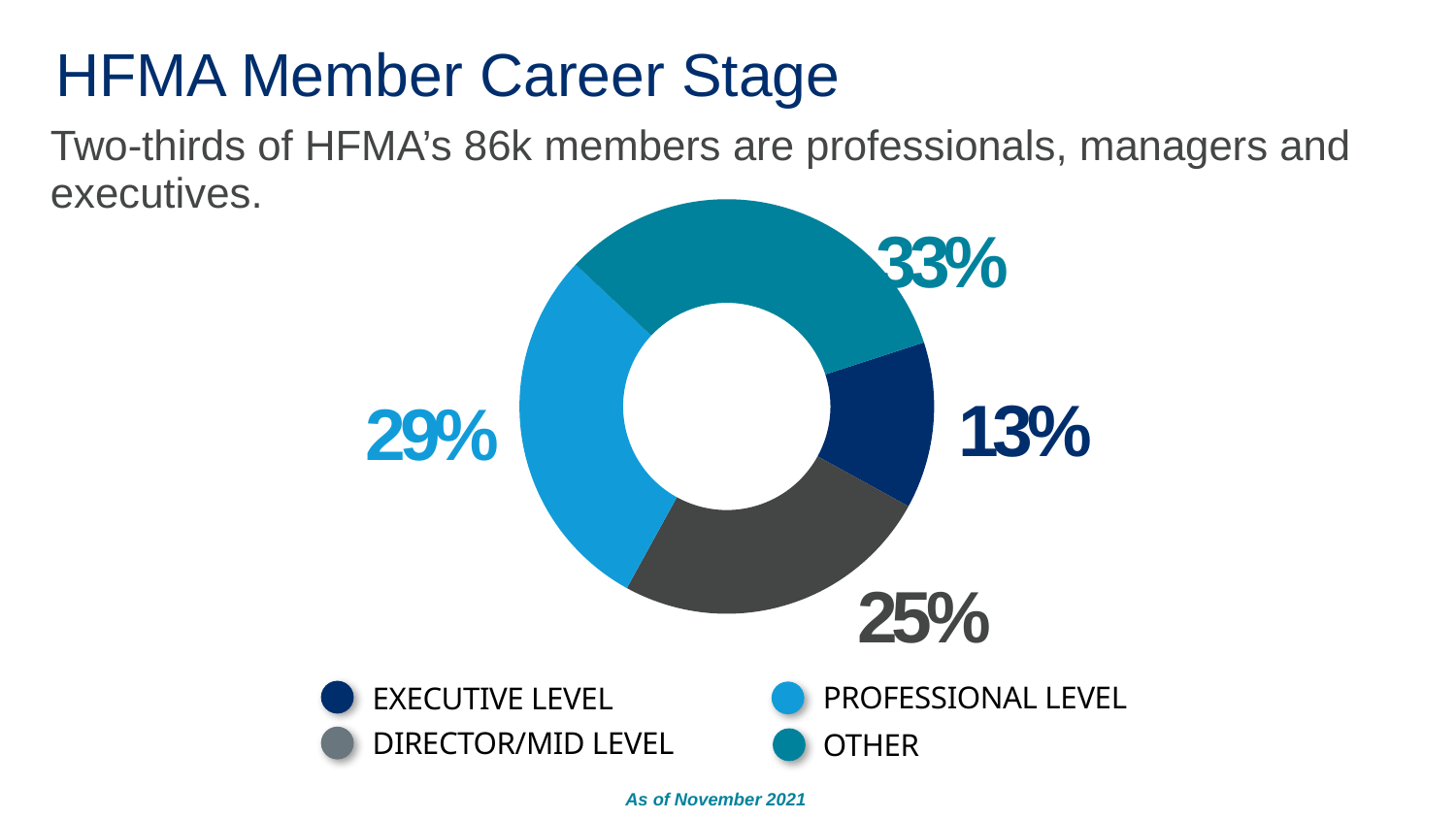
How many percentage points larger is the Professional Level share than the Executive Level share? 16 How many categories does the chart show? 4 Which career stage category has the largest share of members? Other What is the title of the slide containing the chart? HFMA Member Career Stage Which is larger, the Director/Mid Level share or the Professional Level share? Professional Level What percentage of HFMA members are at the Professional Level? 29% What date note appears below the chart legend? As of November 2021 Which career stage category has the smallest share of members? Executive Level What percentage of HFMA members are at the Executive Level? 13% What kind of chart is shown on the slide? Pie chart (donut) What percentage of HFMA members fall into the Other category? 33% What percentage of HFMA members are at the Director/Mid Level? 25%